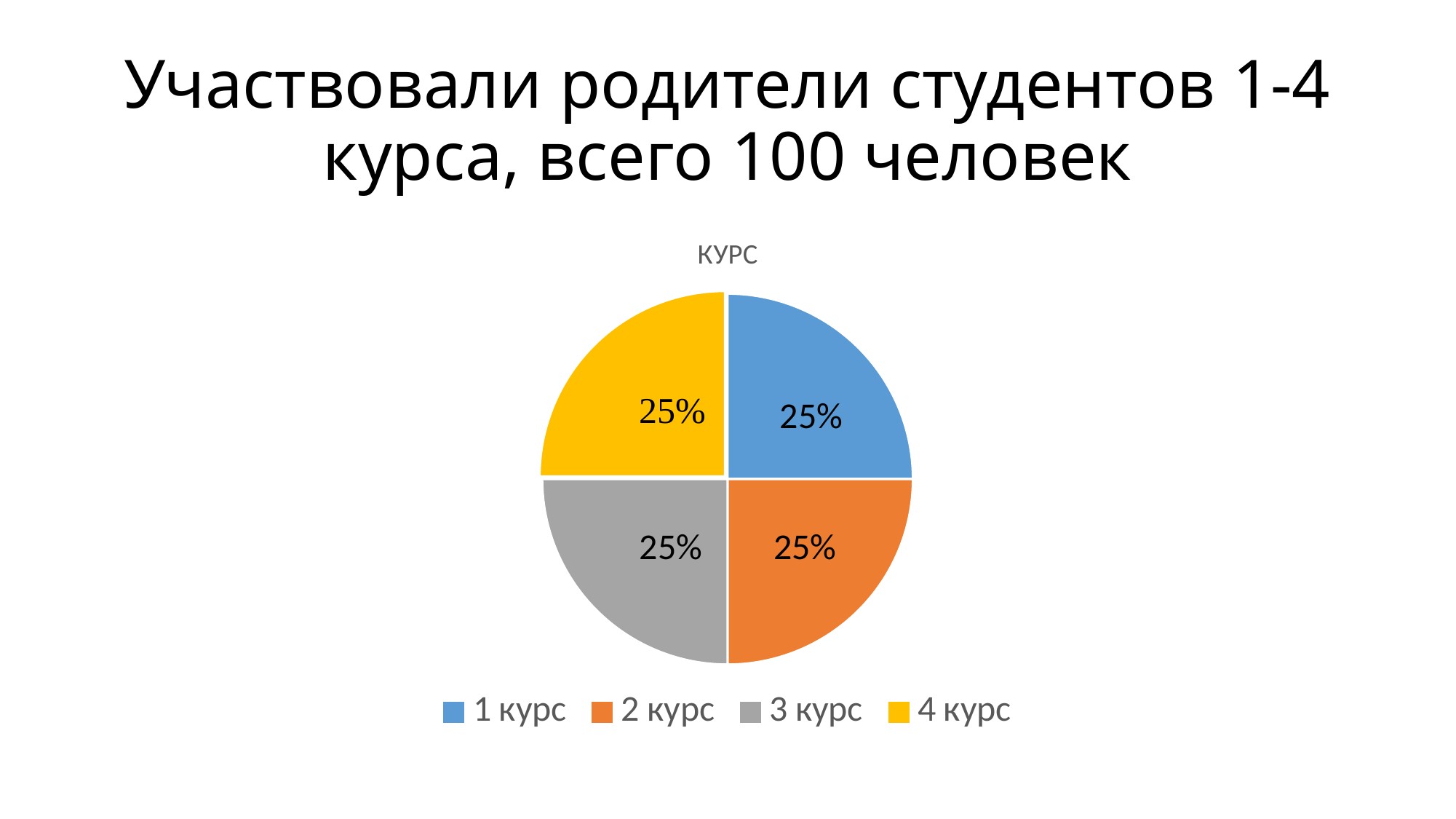
What share is shown for 4 курс? 25% What kind of chart is shown on the slide? Pie chart What is the title of the chart? КУРС Which colour represents 4 курс in the legend? Yellow Is the share for 4 курс greater or less than 50%? less How many slices does the pie chart have? 4 What share of the pie does 1 курс represent? 25% What percentage is labelled on the 3 курс slice? 25% What is the value shown for 2 курс? 25% How many entries does the legend list? 4 What is the combined share of 1 курс and 2 курс? 50% What is the difference between the shares of 1 курс and 3 курс? 0%